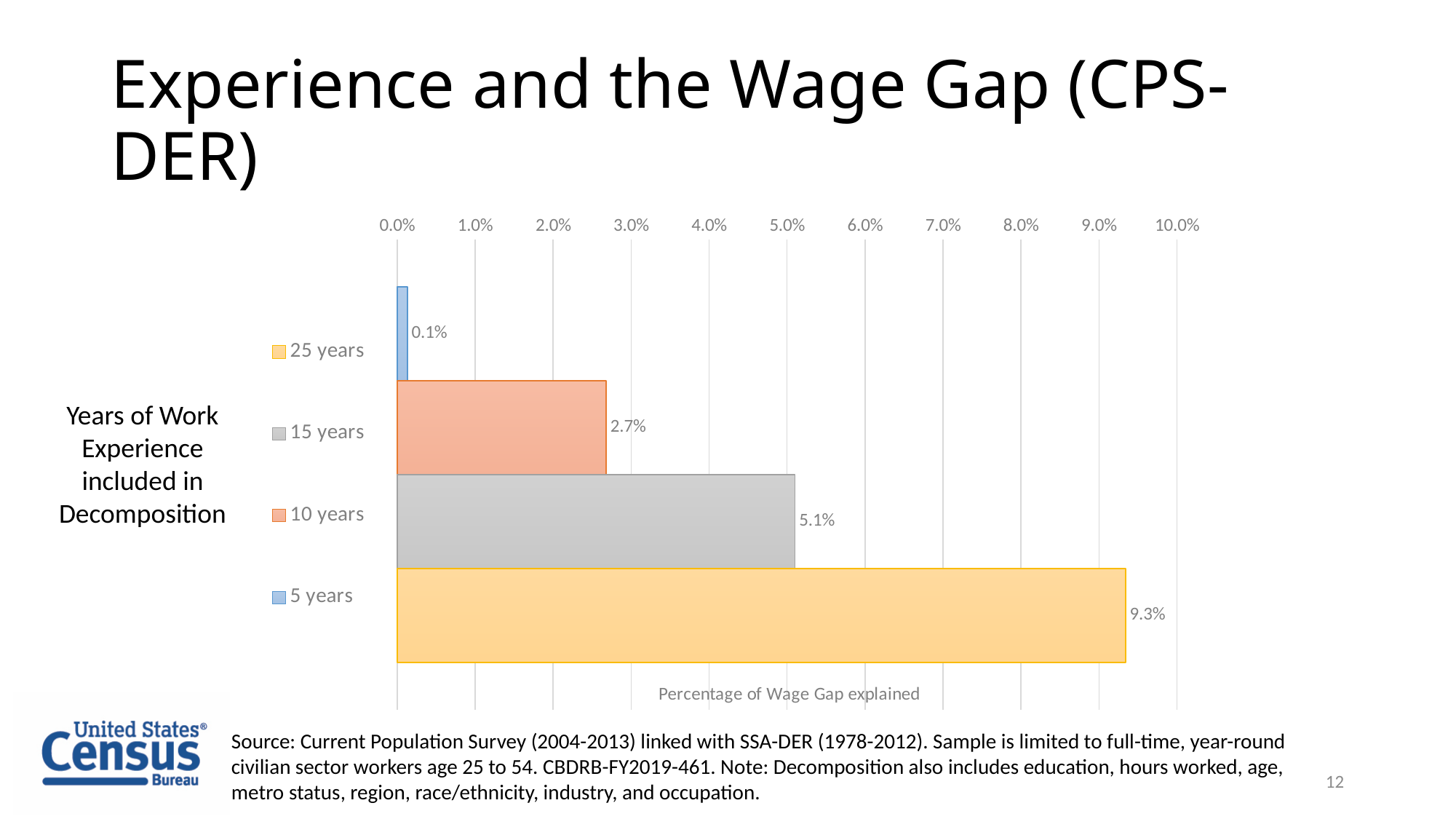
What percentage of the wage gap is explained by 10 years of work experience? 2.7% Which years-of-experience series explains the largest share of the wage gap? 25 years What percentage of the wage gap is explained by 15 years of work experience? 5.1% What percentage of the wage gap is explained by 25 years of work experience? 9.3% What percentage of the wage gap is explained by 5 years of work experience? 0.1% Which explains more of the wage gap: 10 years or 15 years of experience? 15 years How many series does the legend list? 4 Which years-of-experience series explains the smallest share of the wage gap? 5 years What is the difference between the percentage explained by 25 years and by 15 years of experience? 4.2% What kind of chart is shown on the slide? Bar chart Is the value for 25 years greater or less than 9.0%? greater What is the title of the horizontal axis of the chart? Percentage of Wage Gap explained